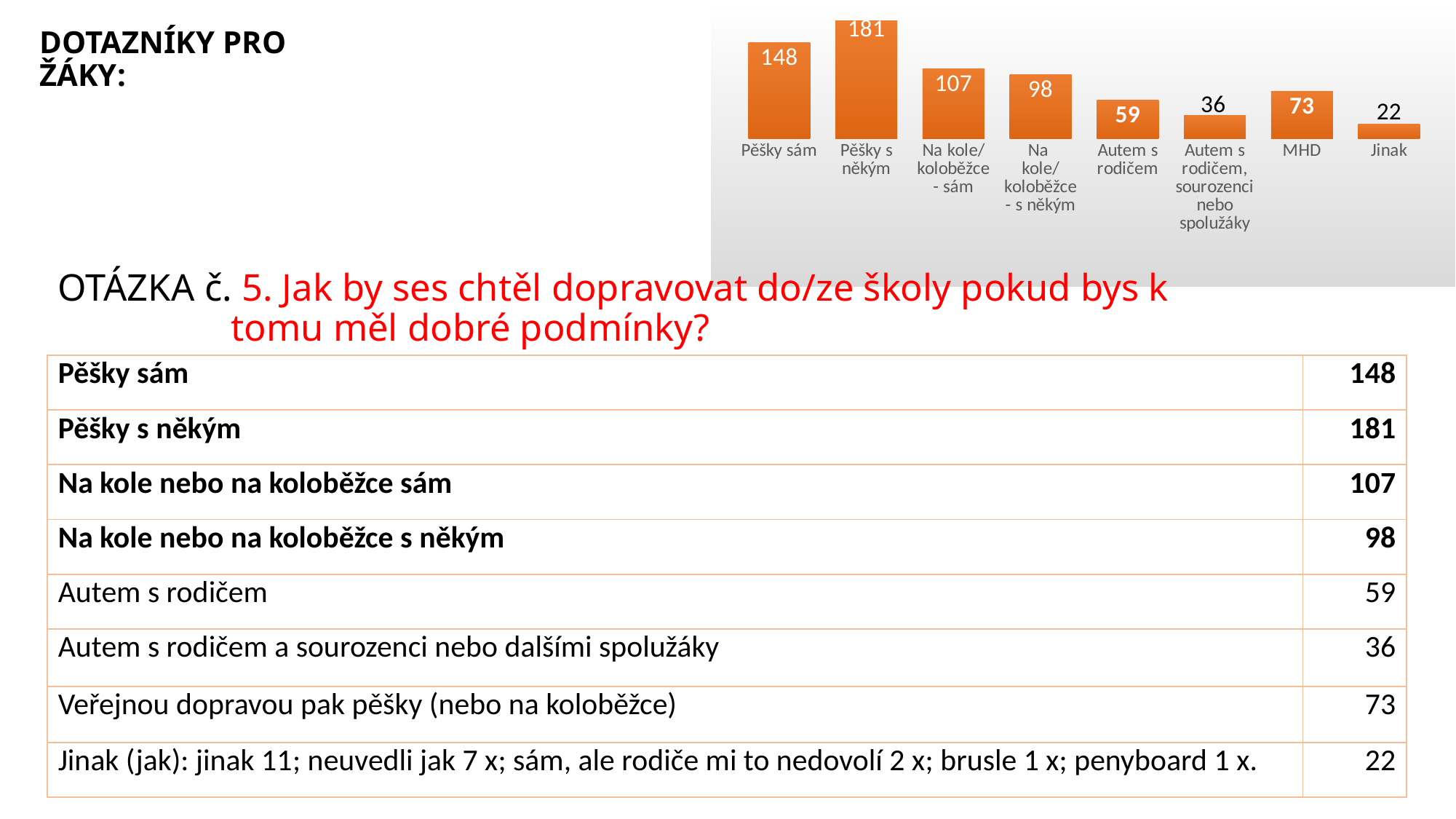
What is the value for 'MHD' in the chart? 73 Which is larger: the value for 'Autem s rodičem' or the value for 'MHD'? MHD What is the value for 'Pěšky sám' in the chart? 148 What is the value for 'Jinak' in the chart? 22 Which category has the highest value in the chart? Pěšky s někým Which category has the lowest value in the chart? Jinak What is the difference between the values for 'Pěšky s někým' and 'Pěšky sám'? 33 How many categories are shown in the chart? 8 What kind of chart is shown on the slide? bar chart What is the difference between the values for 'Na kole/koloběžce - sám' and 'Na kole/koloběžce - s někým'? 9 Which is larger: the value for 'Autem s rodičem, sourozenci nebo spolužáky' or the value for 'Jinak'? Autem s rodičem, sourozenci nebo spolužáky What colour are the bars in the chart? orange